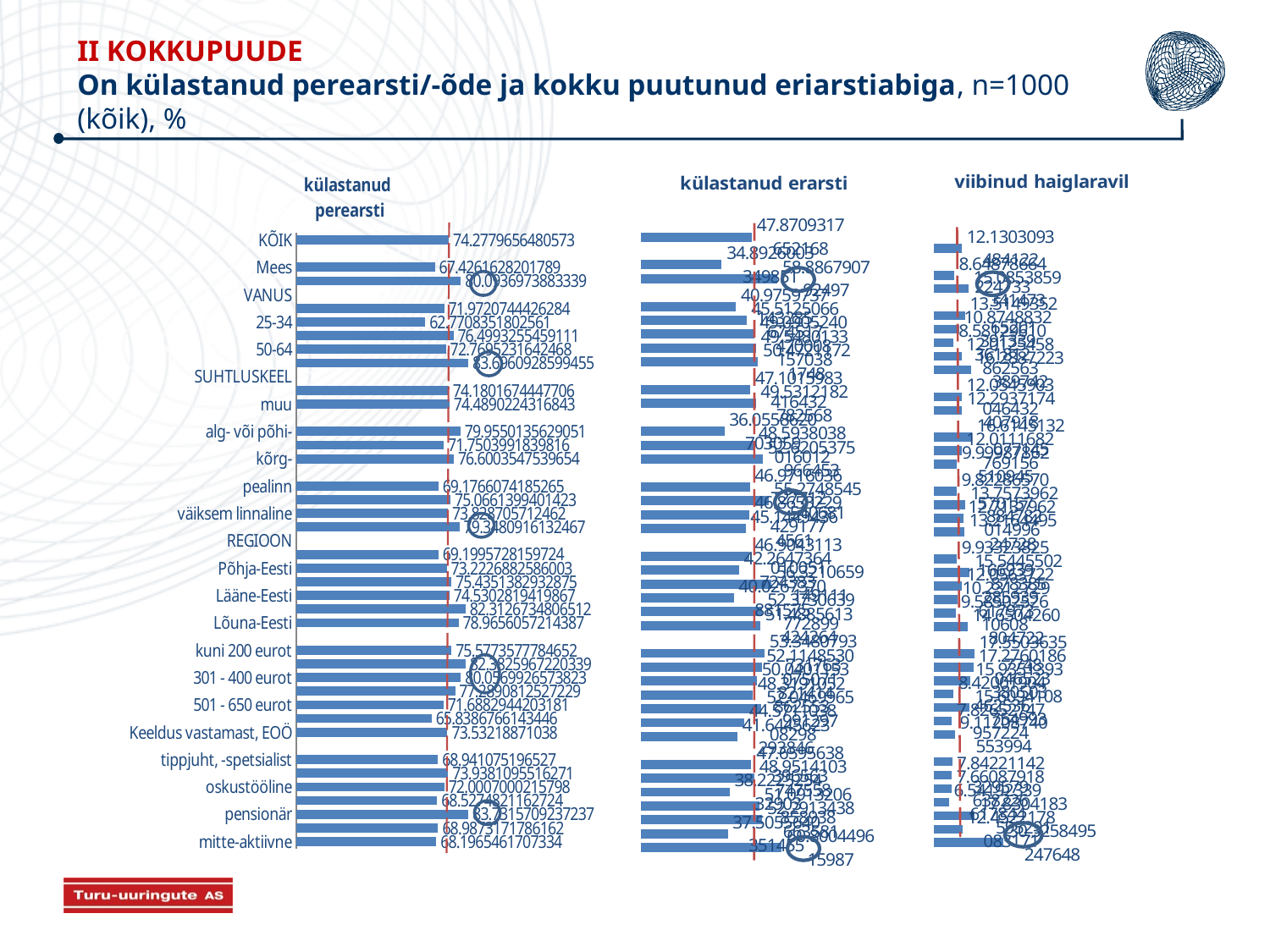
In the 'külastanud erarsti' chart, what is the value for KÕIK? 47.8709317 What are the titles of the three charts on the slide, from left to right? külastanud perearsti, külastanud erarsti, viibinud haiglaravil In the 'viibinud haiglaravil' chart, what is the value for KÕIK? 12.1303093 What kind of chart is used on this slide? bar chart In the 'külastanud perearsti' chart, which labelled category has the lowest value? 25-34 In the 'külastanud perearsti' chart, what is the value for mitte-aktiivne? 68.1965461707334 In the 'külastanud perearsti' chart, what is the value for KÕIK? 74.2779656480573 How many charts are shown on the slide? 3 In the 'külastanud perearsti' chart, what is the value for Lõuna-Eesti? 78.9656057214387 In the 'külastanud perearsti' chart, what is the value for Mees? 67.4261628201789 In the 'külastanud perearsti' chart, which has the larger value, Mees or Lõuna-Eesti? Lõuna-Eesti In the 'külastanud perearsti' chart, what is the value for 25-34? 62.7708351802561